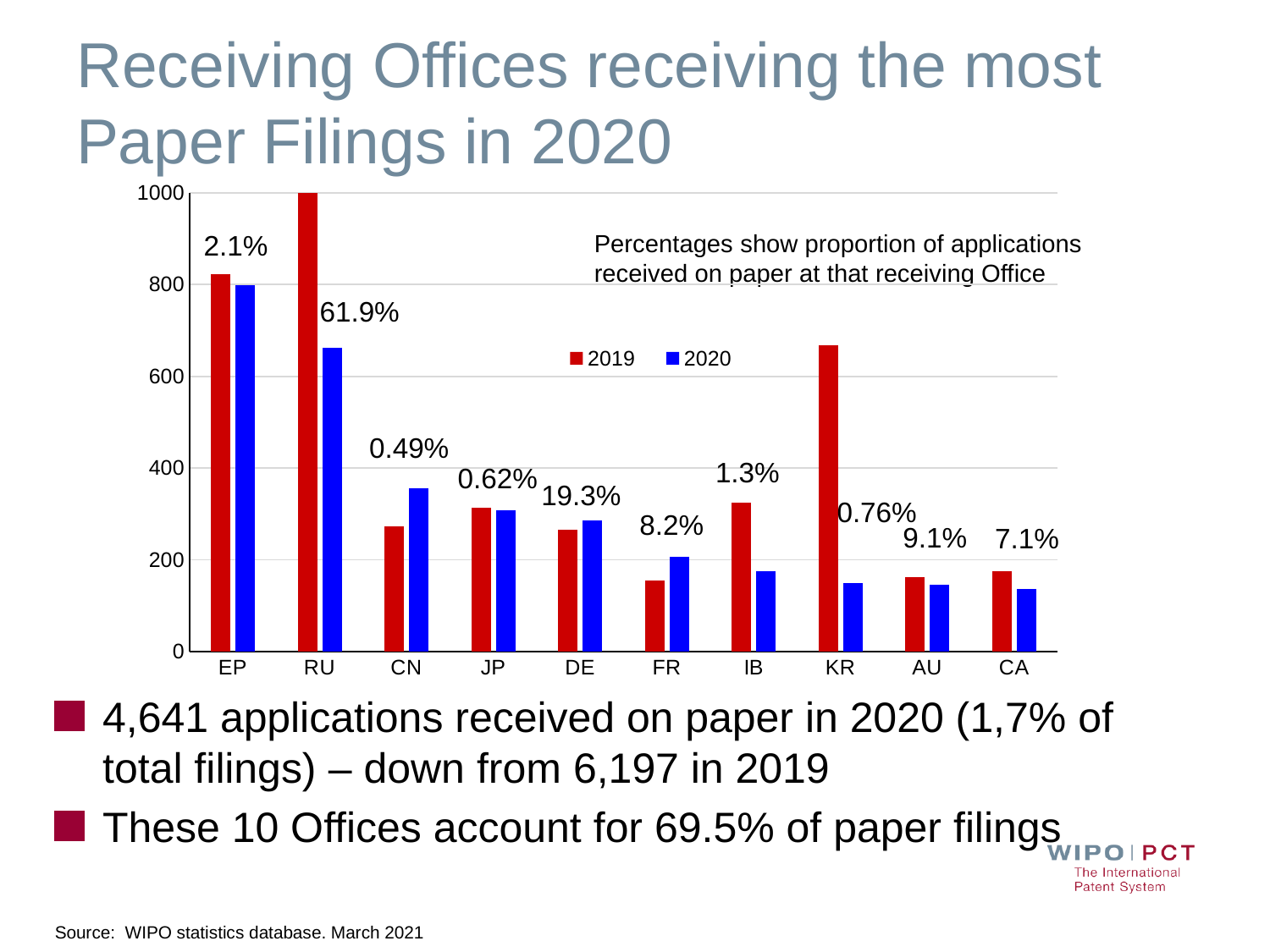
How many receiving Offices are shown on the x axis of the chart? 10 Which receiving Office has the tallest 2019 bar? RU For CN, which bar is taller: 2019 or 2020? 2020 Which colour represents the 2020 series in the chart? blue What kind of chart is shown on the slide? bar chart What percentage label is shown above the CN bars? 0.49% Which receiving Office has the tallest 2020 bar? EP How many series does the chart's legend list? 2 What percentage label is shown above the DE bars? 19.3% For KR, which bar is taller: 2019 or 2020? 2019 What percentage of applications were received on paper at RU, according to the label on the chart? 61.9% Is the 2020 value for CN greater or less than 400? less